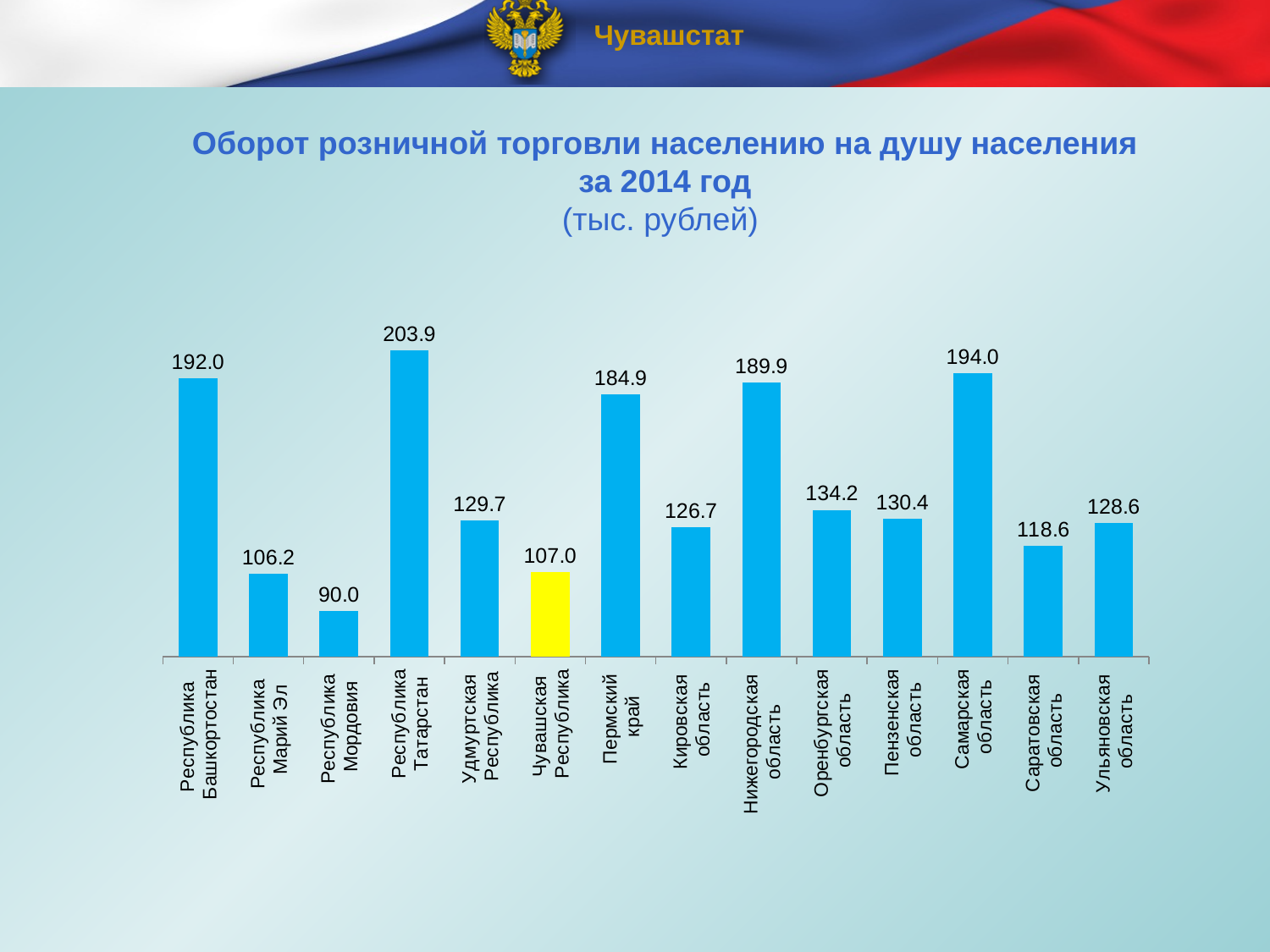
Which region's bar is highlighted in yellow? Чувашская Республика Which is larger, the value for Оренбургская область or the value for Пензенская область? Оренбургская область What kind of chart is shown on the slide? Bar chart Which region has the lowest value? Республика Мордовия How many regions are shown in the chart? 14 What is the value for Республика Башкортостан? 192.0 What is the value for Чувашская Республика? 107.0 Which is larger, the value for Пермский край or the value for Нижегородская область? Нижегородская область What is the difference between the values for Самарская область and Чувашская Республика? 87.0 Which region has the highest value? Республика Татарстан What is the value for Саратовская область? 118.6 What is the difference between the values for Республика Татарстан and Республика Мордовия? 113.9